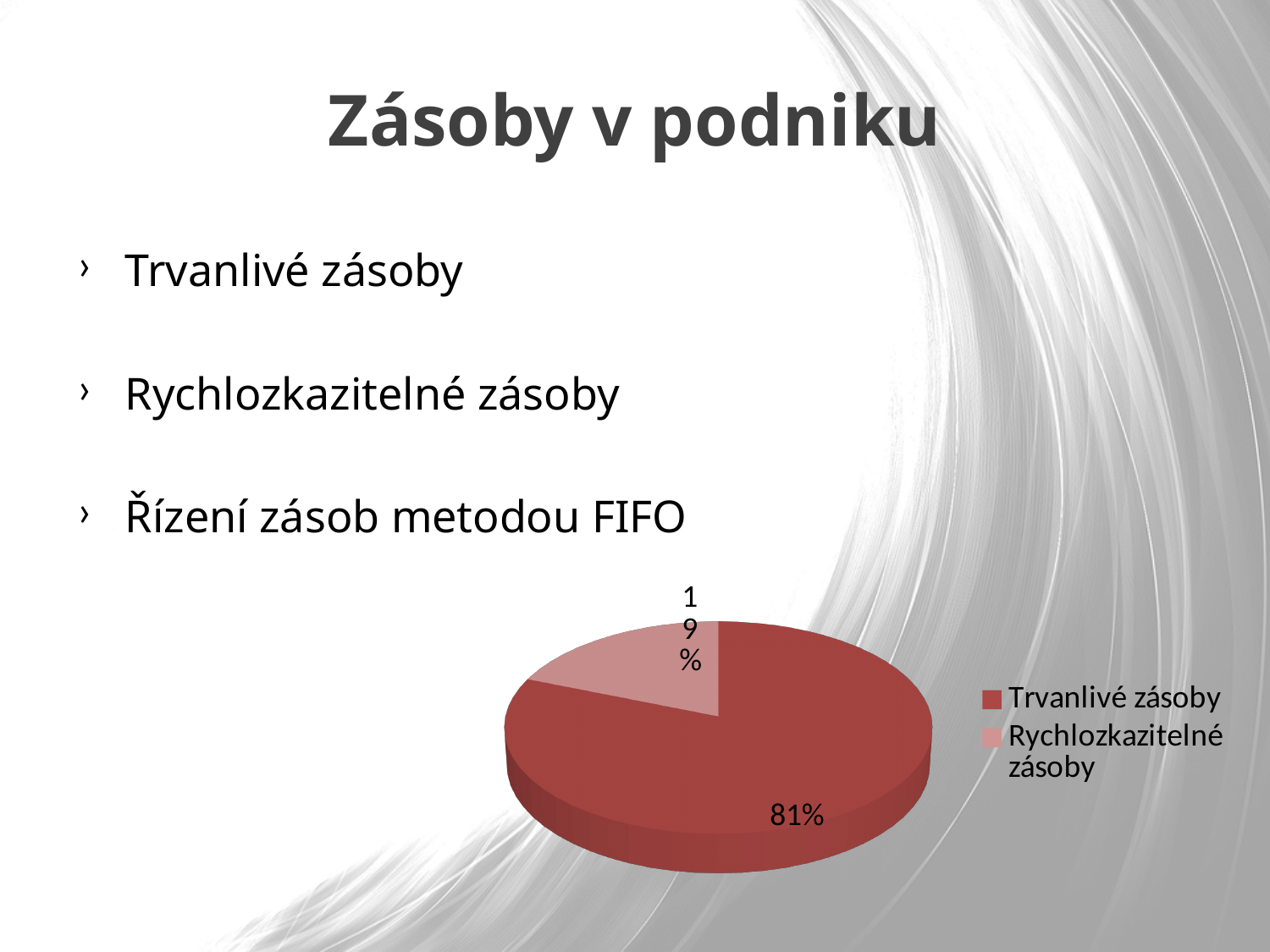
What share of the pie does Rychlozkazitelné zásoby represent? 19% What kind of chart is shown on the slide? pie chart Which slice of the pie is the largest? Trvanlivé zásoby Which slice of the pie is the smallest? Rychlozkazitelné zásoby What is the difference in percentage points between Trvanlivé zásoby and Rychlozkazitelné zásoby? 62 How many entries does the legend list? 2 Which is larger, the share for Trvanlivé zásoby or the share for Rychlozkazitelné zásoby? Trvanlivé zásoby What share of the pie does Trvanlivé zásoby represent? 81% Which legend entry is shown in the darker red colour? Trvanlivé zásoby Which legend entry is shown in the lighter pink colour? Rychlozkazitelné zásoby How many slices does the pie chart have? 2